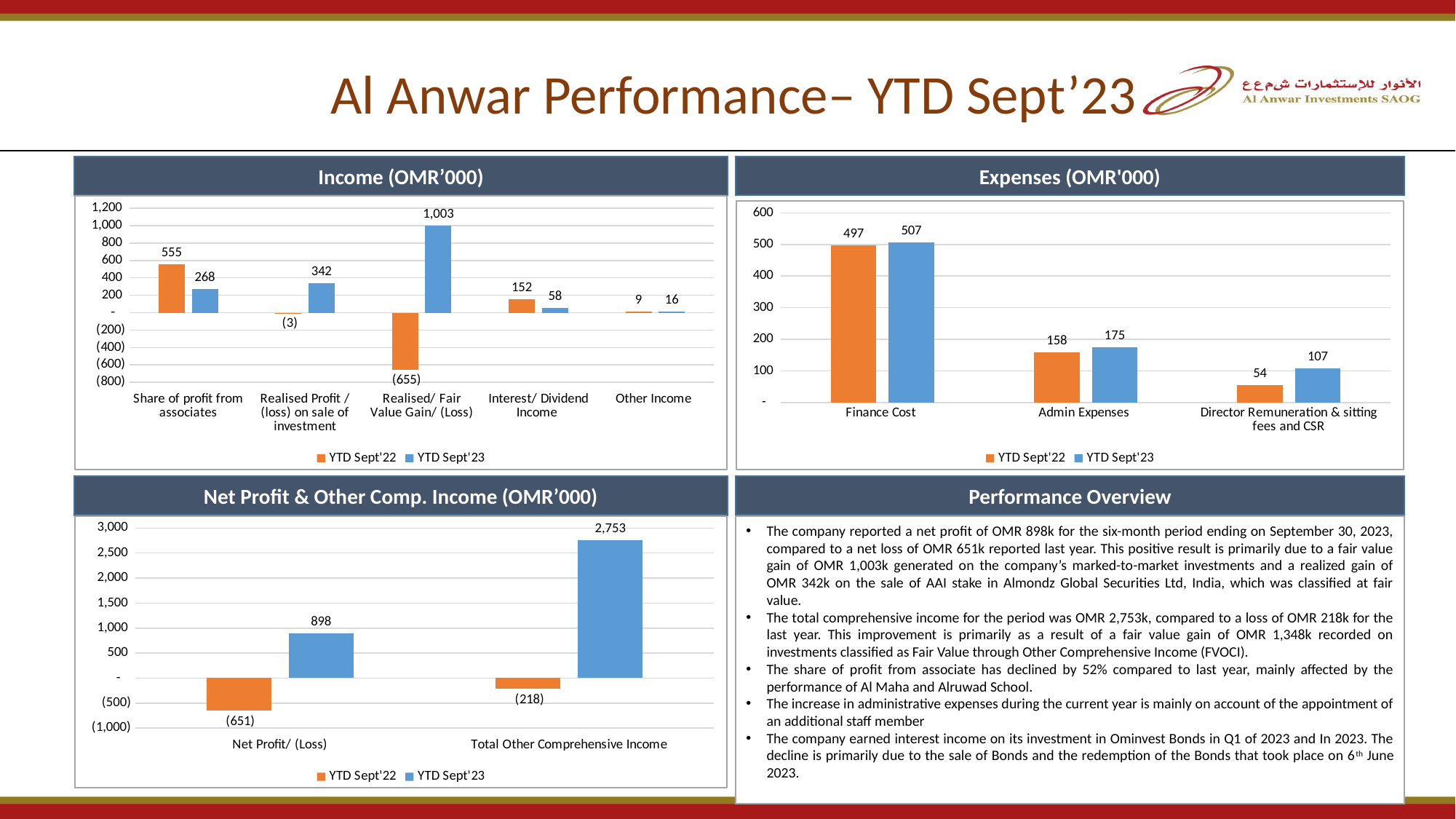
In the Income (OMR'000) chart, what is the difference between the YTD Sept'22 and YTD Sept'23 values for Interest/ Dividend Income? 94 In the Expenses (OMR'000) chart, what is the YTD Sept'23 value for Admin Expenses? 175 How many categories are shown on the x axis of the Income (OMR'000) chart? 5 In the Net Profit & Other Comp. Income (OMR'000) chart, what is the YTD Sept'23 value for Total Other Comprehensive Income? 2,753 In the Net Profit & Other Comp. Income (OMR'000) chart, what is the YTD Sept'22 value for Net Profit/ (Loss)? (651) In the Expenses (OMR'000) chart, is the YTD Sept'22 value for Director Remuneration & sitting fees and CSR larger or smaller than the YTD Sept'23 value? smaller In the Income (OMR'000) chart, what is the YTD Sept'23 value for Realised/ Fair Value Gain/ (Loss)? 1,003 In the Expenses (OMR'000) chart, what is the difference between the YTD Sept'23 and YTD Sept'22 values for Finance Cost? 10 In the Income (OMR'000) chart, which category has the lowest YTD Sept'22 value? Realised/ Fair Value Gain/ (Loss) How many series does the legend of the Net Profit & Other Comp. Income (OMR'000) chart list? 2 In the Income (OMR'000) chart, what is the YTD Sept'22 value for Share of profit from associates? 555 In the Expenses (OMR'000) chart, which category has the highest YTD Sept'23 value? Finance Cost